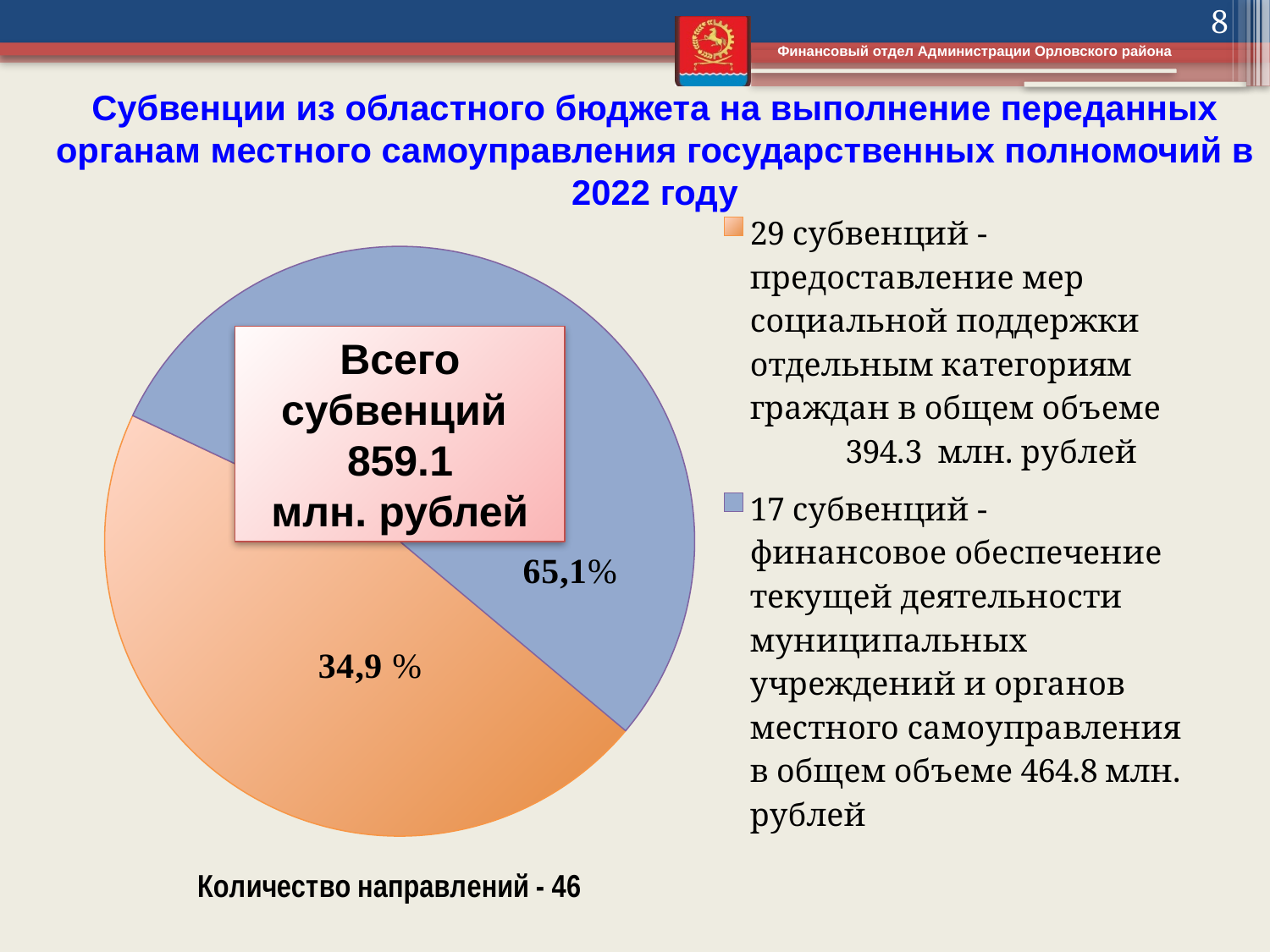
How many subventions are listed for social support measures for certain categories of citizens? 29 What is the total amount of subventions shown in the centre of the pie chart? 859.1 млн. рублей How many slices does the pie chart have? 2 What is the number of directions (Количество направлений) stated below the pie chart? 46 What is the total amount for the subventions on financial support of current activities of municipal institutions and local government bodies? 464.8 млн. рублей What percentage is printed on the orange slice of the pie chart? 34,9 % What is the total amount for the subventions on social support measures for certain categories of citizens (предоставление мер социальной поддержки)? 394.3 млн. рублей What percentage is printed on the blue slice of the pie chart? 65,1% By how much does the amount for financial support of municipal institutions (464.8) exceed the amount for social support measures (394.3)? 70.5 млн. рублей Which is larger: the amount for social support measures or the amount for financial support of municipal institutions? financial support of municipal institutions (464.8 млн. рублей) Which slice of the pie chart is the largest? the blue slice (финансовое обеспечение текущей деятельности муниципальных учреждений и органов местного самоуправления), 65,1% What kind of chart is shown on the slide? pie chart